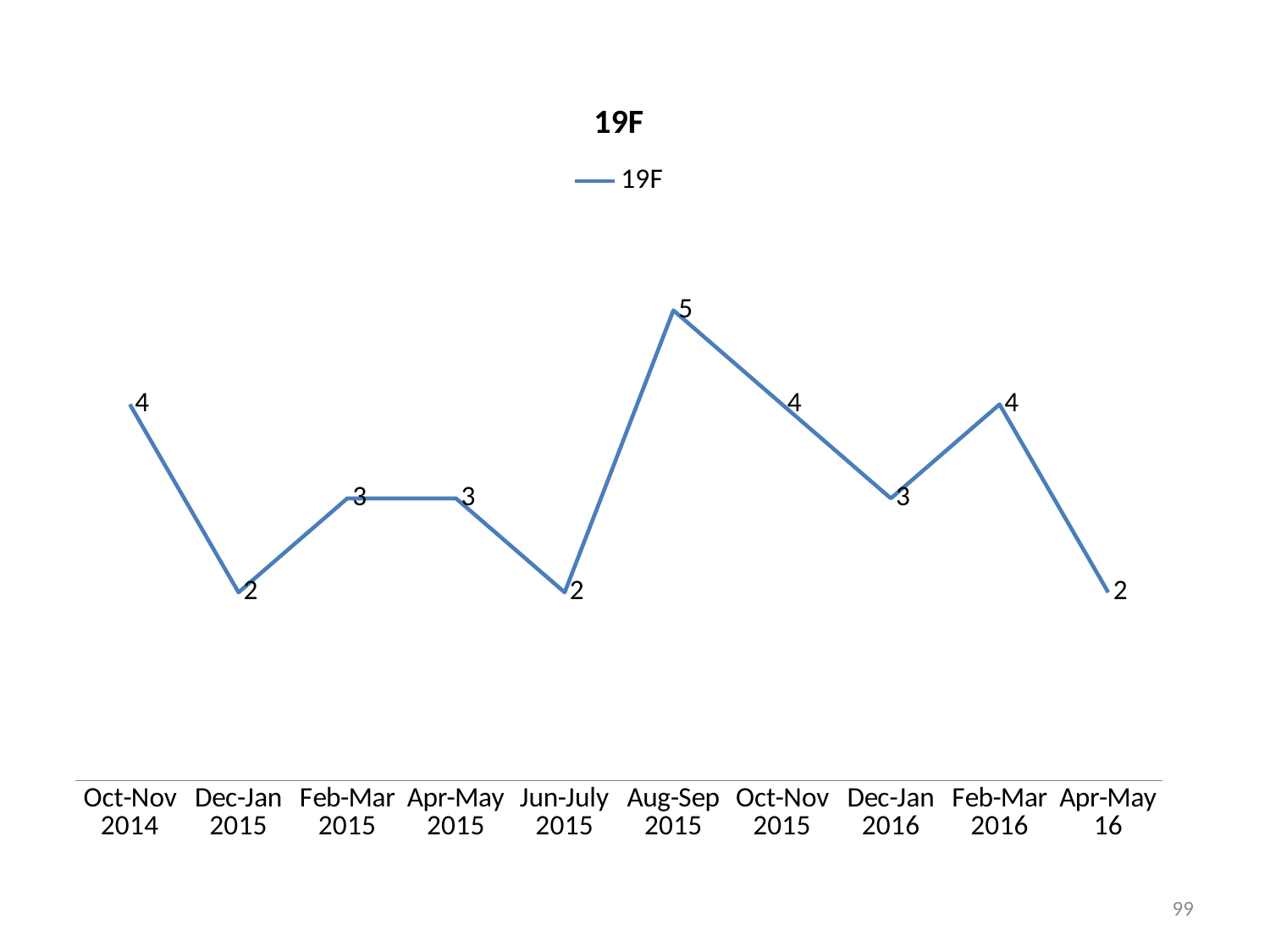
What is the value for Oct-Nov 2014? 4 Which is larger, the value for Feb-Mar 2016 or the value for Apr-May 16? Feb-Mar 2016 What is the difference between the values for Aug-Sep 2015 and Jun-July 2015? 3 What is the value for Dec-Jan 2016? 3 How many series does the legend list? 1 What is the value for Aug-Sep 2015? 5 Which period has the highest value? Aug-Sep 2015 What is the title of the chart? 19F What is the value for Apr-May 16? 2 What is the difference between the values for Oct-Nov 2014 and Dec-Jan 2015? 2 What kind of chart is shown? line chart How many periods are plotted on the x axis? 10